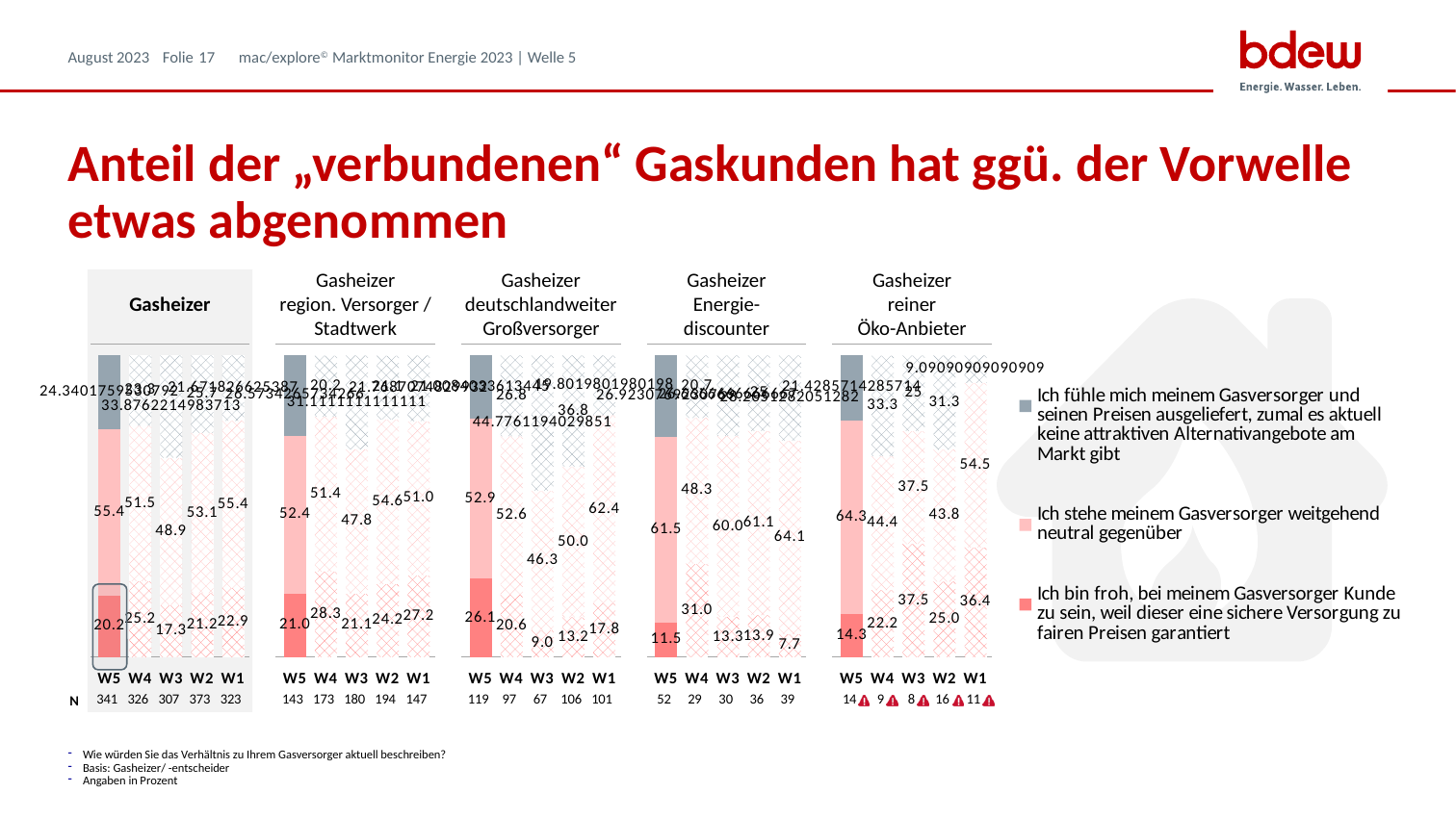
In the 'Gasheizer deutschlandweiter Großversorger' group, which is larger for the series 'Ich stehe meinem Gasversorger weitgehend neutral gegenüber': W1 or W3? W1 In the 'Gasheizer region. Versorger / Stadtwerk' group, what is the difference between W4 and W5 for the series 'Ich bin froh, bei meinem Gasversorger Kunde zu sein'? 7.3 In the 'Gasheizer Energie-discounter' group, which wave has the lowest value for the series 'Ich bin froh, bei meinem Gasversorger Kunde zu sein'? W1 In the 'Gasheizer' group, what is the value for W4 of the series 'Ich stehe meinem Gasversorger weitgehend neutral gegenüber'? 51.5 How many series does the legend list? 3 What is the N (base) for W5 in the 'Gasheizer' group? 341 What kind of chart is shown on the slide? stacked bar chart In the 'Gasheizer deutschlandweiter Großversorger' group, what is the value for W3 of the series 'Ich bin froh, bei meinem Gasversorger Kunde zu sein'? 9.0 In the 'Gasheizer reiner Öko-Anbieter' group, which wave has the highest value for the series 'Ich stehe meinem Gasversorger weitgehend neutral gegenüber'? W5 How many waves (bars) are shown in each group of the chart? 5 In the 'Gasheizer Energie-discounter' group, what is the value for W1 of the series 'Ich stehe meinem Gasversorger weitgehend neutral gegenüber'? 64.1 In the 'Gasheizer' group, what is the value for W5 of the series 'Ich bin froh, bei meinem Gasversorger Kunde zu sein'? 20.2